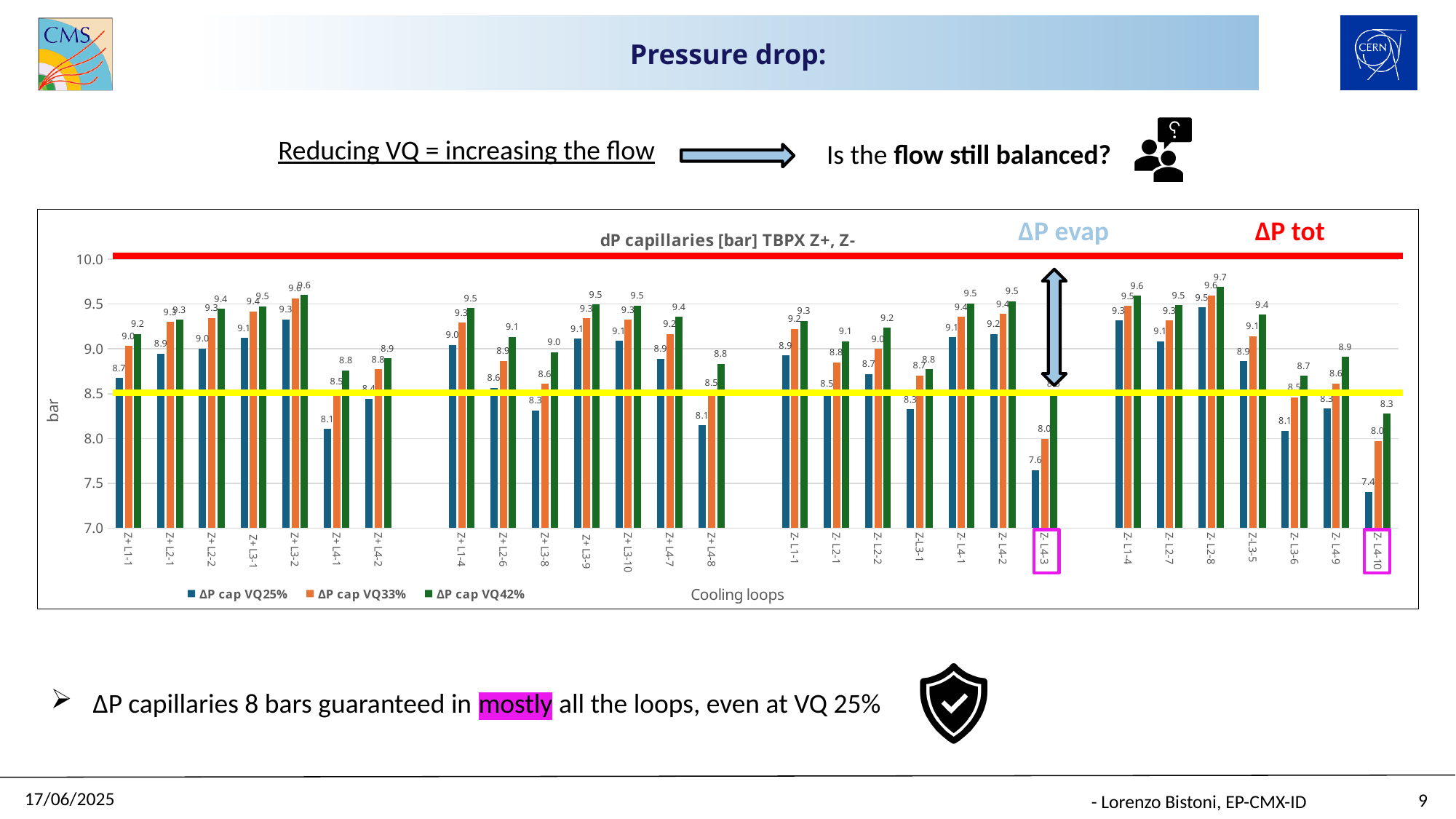
What is the difference between the ΔP cap VQ42% and ΔP cap VQ25% values for cooling loop Z+ L4-1? 0.7 What is the ΔP cap VQ25% value for cooling loop Z- L4-10? 7.4 What is the title of the chart? dP capillaries [bar] TBPX Z+, Z- Is the ΔP cap VQ25% value for cooling loop Z- L4-3 greater or less than 8.0? less What is the ΔP cap VQ42% value for cooling loop Z- L2-8? 9.7 What is the label of the x axis of the chart? Cooling loops What is the ΔP cap VQ33% value for cooling loop Z+ L1-1? 9.0 How many series does the chart legend list? 3 Which cooling loop has the highest ΔP cap VQ42% value? Z- L2-8 What type of chart is shown on the slide? bar chart Which cooling loop has the lowest ΔP cap VQ25% value? Z- L4-10 Which is larger for cooling loop Z- L3-6: the ΔP cap VQ25% value or the ΔP cap VQ33% value? ΔP cap VQ33%